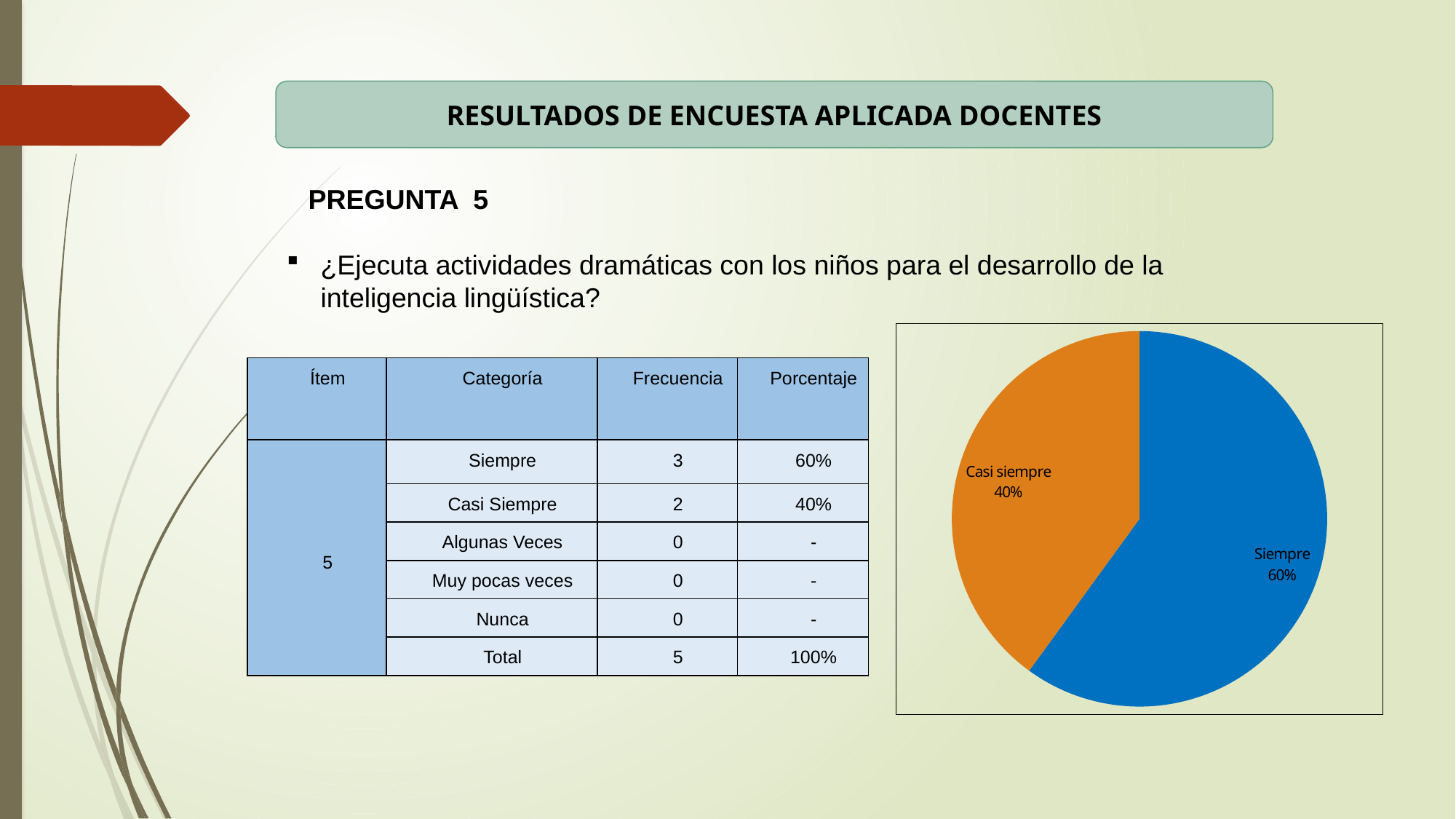
What is the difference in percentage points between the Siempre and Casi siempre slices? 20 percentage points What share of the pie does the Casi siempre slice represent? 40% What colour is the Casi siempre slice in the pie chart? orange What kind of chart is shown on the slide? pie chart Is the share for Siempre greater or less than 50%? greater Which slice of the pie chart is the smallest? Casi siempre Which slice is larger, Siempre or Casi siempre? Siempre What colour is the Siempre slice in the pie chart? blue How many slices does the pie chart have? 2 What share of the pie does the Siempre slice represent? 60% Which slice of the pie chart is the largest? Siempre